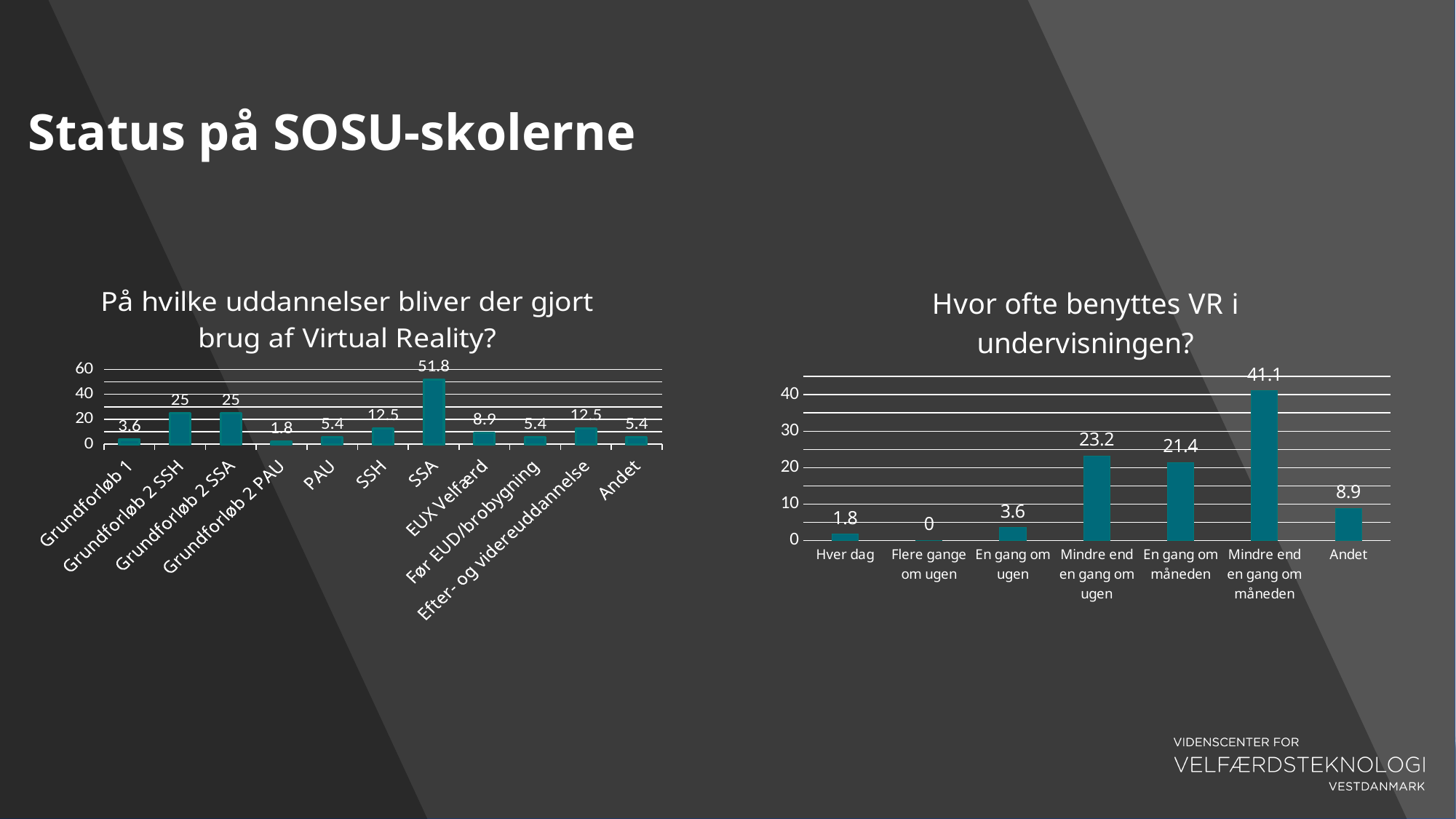
In the chart 'Hvor ofte benyttes VR i undervisningen?', how many categories are shown on the x axis? 7 In the chart 'På hvilke uddannelser bliver der gjort brug af Virtual Reality?', which category has the lowest value? Grundforløb 2 PAU In the chart 'På hvilke uddannelser bliver der gjort brug af Virtual Reality?', how many categories are shown on the x axis? 11 In the chart 'På hvilke uddannelser bliver der gjort brug af Virtual Reality?', what is the value for SSA? 51.8 What type of chart is 'Hvor ofte benyttes VR i undervisningen?'? Bar chart In the chart 'På hvilke uddannelser bliver der gjort brug af Virtual Reality?', what is the value for Grundforløb 2 PAU? 1.8 In the chart 'På hvilke uddannelser bliver der gjort brug af Virtual Reality?', what is the difference between the values for SSA and EUX Velfærd? 42.9 In the chart 'Hvor ofte benyttes VR i undervisningen?', which is larger: 'Mindre end en gang om ugen' or 'En gang om måneden'? Mindre end en gang om ugen In the chart 'Hvor ofte benyttes VR i undervisningen?', what is the value for 'Mindre end en gang om måneden'? 41.1 In the chart 'Hvor ofte benyttes VR i undervisningen?', what is the value for 'Flere gange om ugen'? 0 In the chart 'På hvilke uddannelser bliver der gjort brug af Virtual Reality?', which category has the highest value? SSA In the chart 'Hvor ofte benyttes VR i undervisningen?', what is the difference between the values for 'Mindre end en gang om måneden' and 'Andet'? 32.2